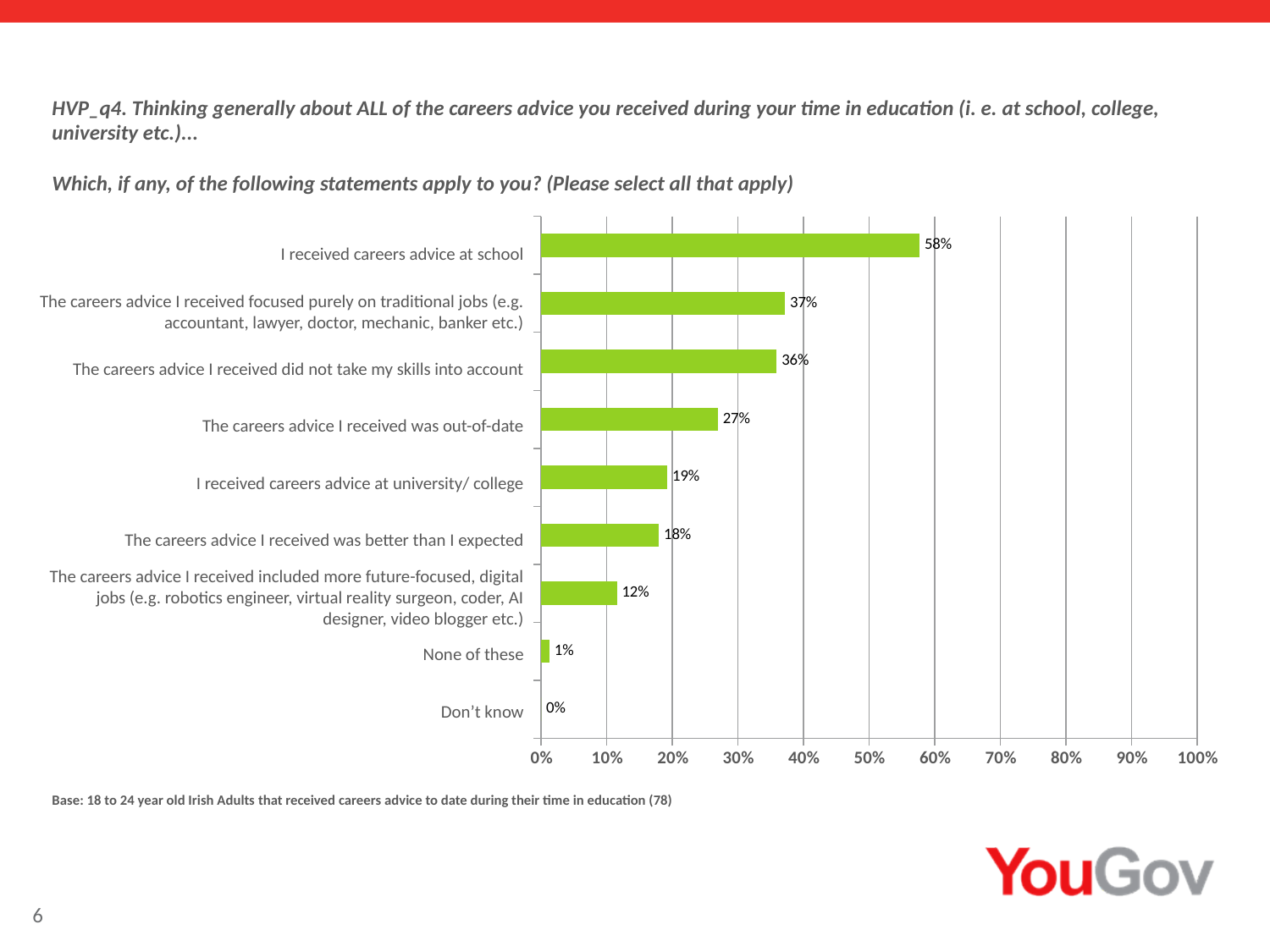
What kind of chart is shown on the slide? Bar chart Which statement has the highest percentage? I received careers advice at school How many categories are shown on the chart? 9 What is the value for 'The careers advice I received was out-of-date'? 27% Which is larger: 'The careers advice I received was out-of-date' or 'The careers advice I received was better than I expected'? The careers advice I received was out-of-date What percentage said the careers advice they received included more future-focused, digital jobs? 12% What is the maximum value shown on the horizontal axis? 100% What is the value for 'None of these'? 1% What percentage of respondents said they received careers advice at school? 58% Which category has the lowest value on the chart? Don't know What is the difference between 'I received careers advice at school' and 'I received careers advice at university/ college'? 39% What is the value for 'I received careers advice at university/ college'? 19%